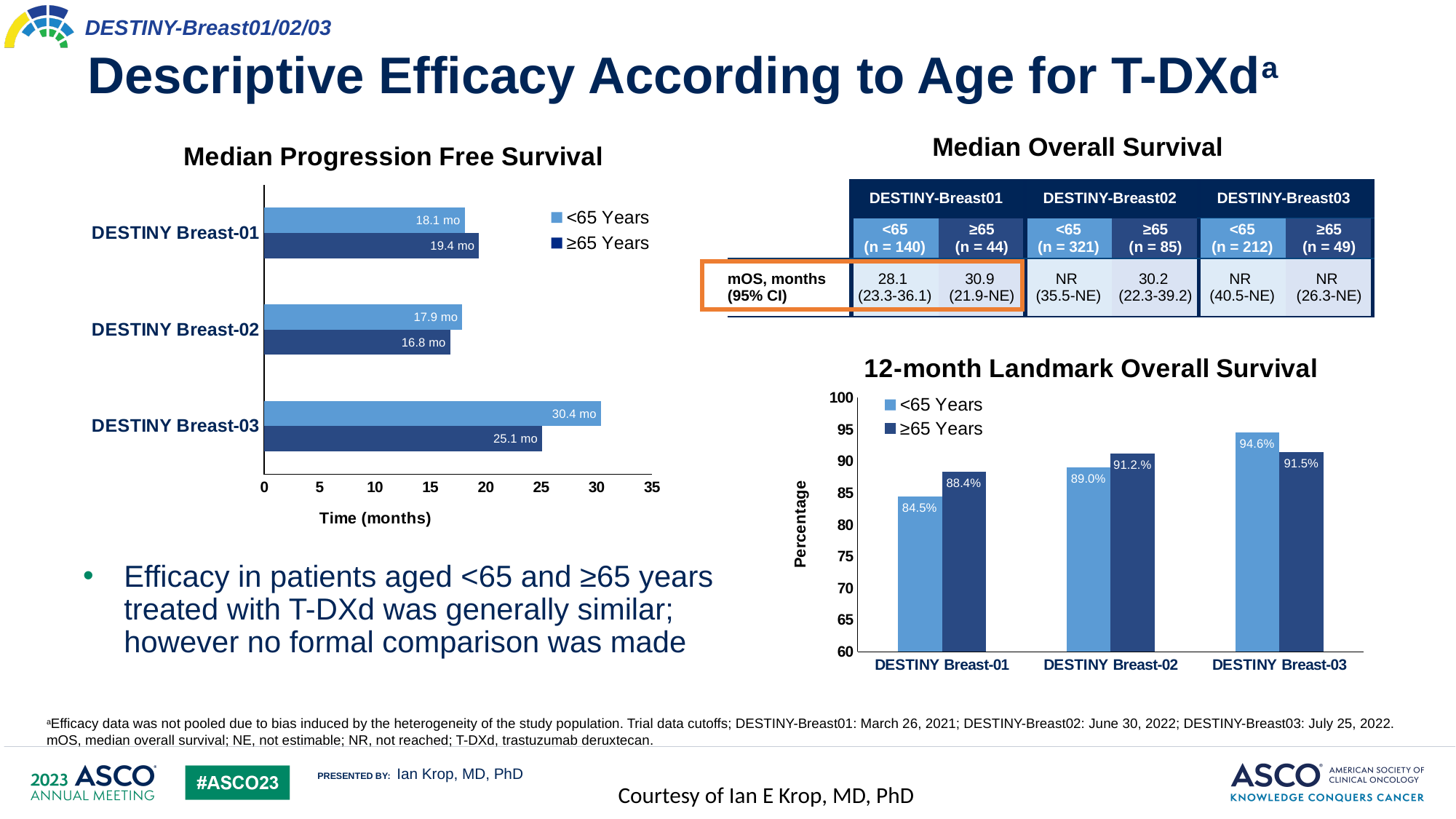
In the Median Progression Free Survival chart, what is the label of the horizontal axis? Time (months) In the 12-month Landmark Overall Survival chart, which is larger for DESTINY Breast-01: the <65 Years value or the ≥65 Years value? ≥65 Years In the 12-month Landmark Overall Survival chart, how many series does the legend list? 2 In the Median Progression Free Survival chart, what is the value for the ≥65 Years series for DESTINY Breast-01? 19.4 mo In the Median Progression Free Survival chart, what is the difference between the <65 Years and ≥65 Years values for DESTINY Breast-03? 5.3 mo In the 12-month Landmark Overall Survival chart, what is the value for the ≥65 Years series for DESTINY Breast-02? 91.2% In the 12-month Landmark Overall Survival chart, do the <65 Years values rise or fall from DESTINY Breast-01 to DESTINY Breast-03? Rise In the Median Progression Free Survival chart, which trial has the lowest value for the ≥65 Years series? DESTINY Breast-02 In the Median Progression Free Survival chart, what is the value for the <65 Years series for DESTINY Breast-03? 30.4 mo In the Median Progression Free Survival chart, which trial has the highest value for the <65 Years series? DESTINY Breast-03 In the 12-month Landmark Overall Survival chart, what is the value for the <65 Years series for DESTINY Breast-01? 84.5% In the Median Progression Free Survival chart, what kind of chart is shown? Bar chart